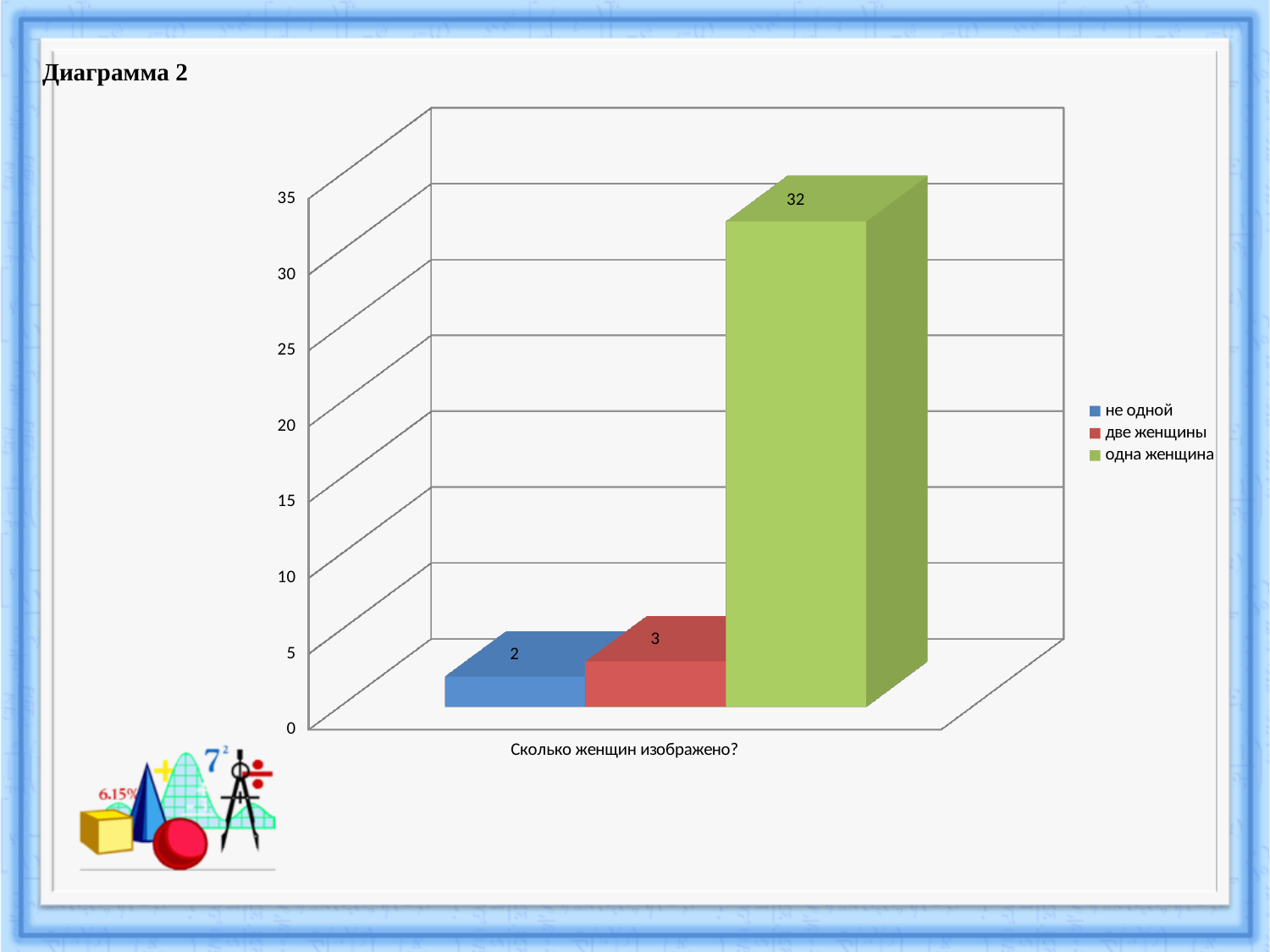
Which series has the highest value? одна женщина What is the value for "не одной"? 2 Is the value for "одна женщина" greater or less than 30? greater What is the difference between the values for "одна женщина" and "две женщины"? 29 What is the difference between the values for "две женщины" and "не одной"? 1 Which is larger, the value for "одна женщина" or the value for "не одной"? одна женщина What is the label shown on the x axis of the chart? Сколько женщин изображено? What is the value for "одна женщина"? 32 What kind of chart is shown on the slide? bar chart How many series does the legend list? 3 Which series has the lowest value? не одной What is the value for "две женщины"? 3